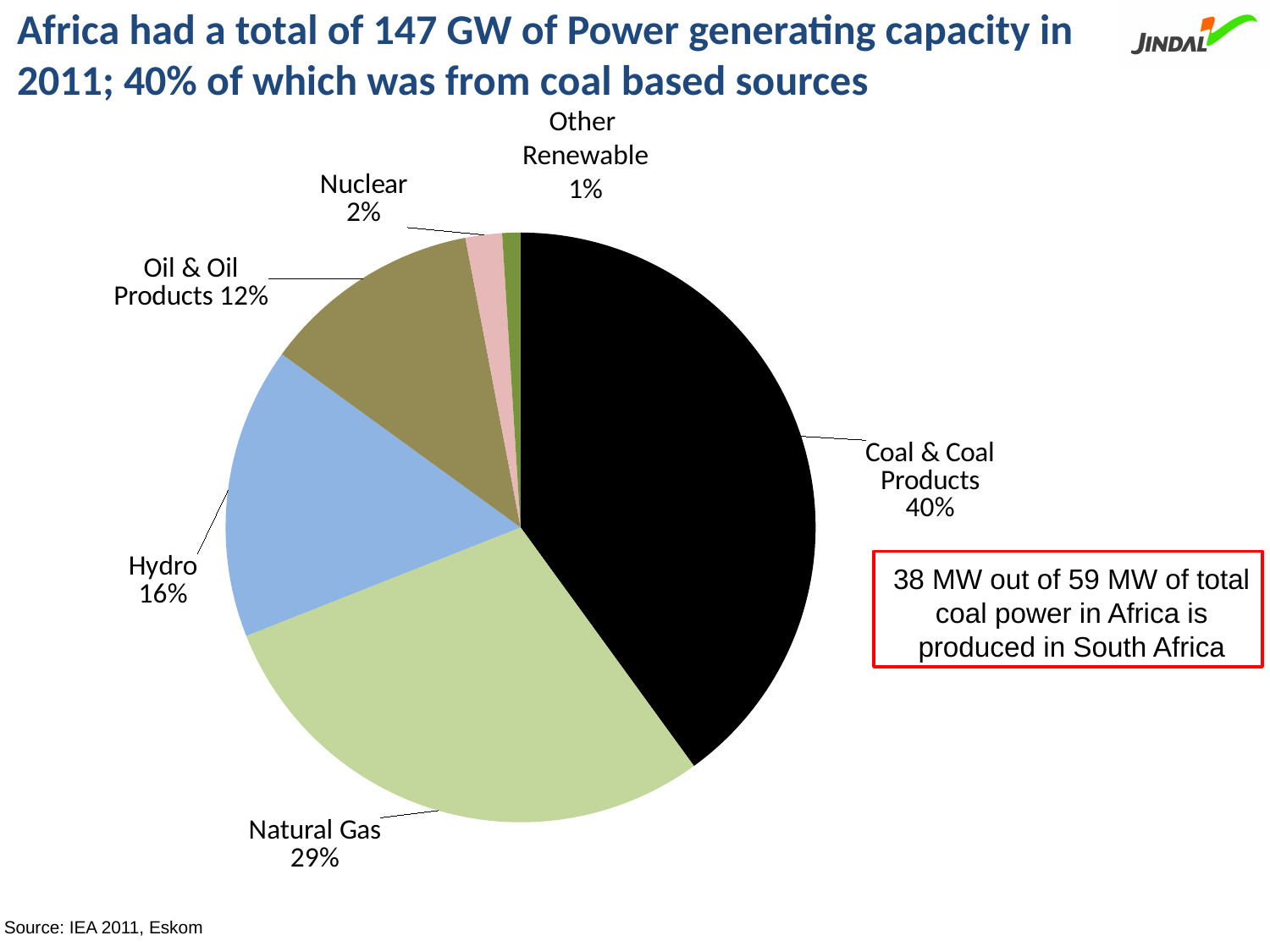
What share of Africa's power generating capacity comes from Coal & Coal Products? 40% What type of chart is shown on the slide? Pie chart Which source has the largest slice of the pie? Coal & Coal Products Which source has the smallest slice of the pie? Other Renewable Which is larger, the Hydro slice or the Oil & Oil Products slice? Hydro What share does Nuclear have in the pie chart? 2% How many slices does the pie chart have? 6 What is the difference in percentage points between Coal & Coal Products and Natural Gas? 11 What colour is the Coal & Coal Products slice? Black What percentage is shown for Hydro? 16% What share of the pie is Natural Gas? 29% What percentage is shown for Oil & Oil Products? 12%